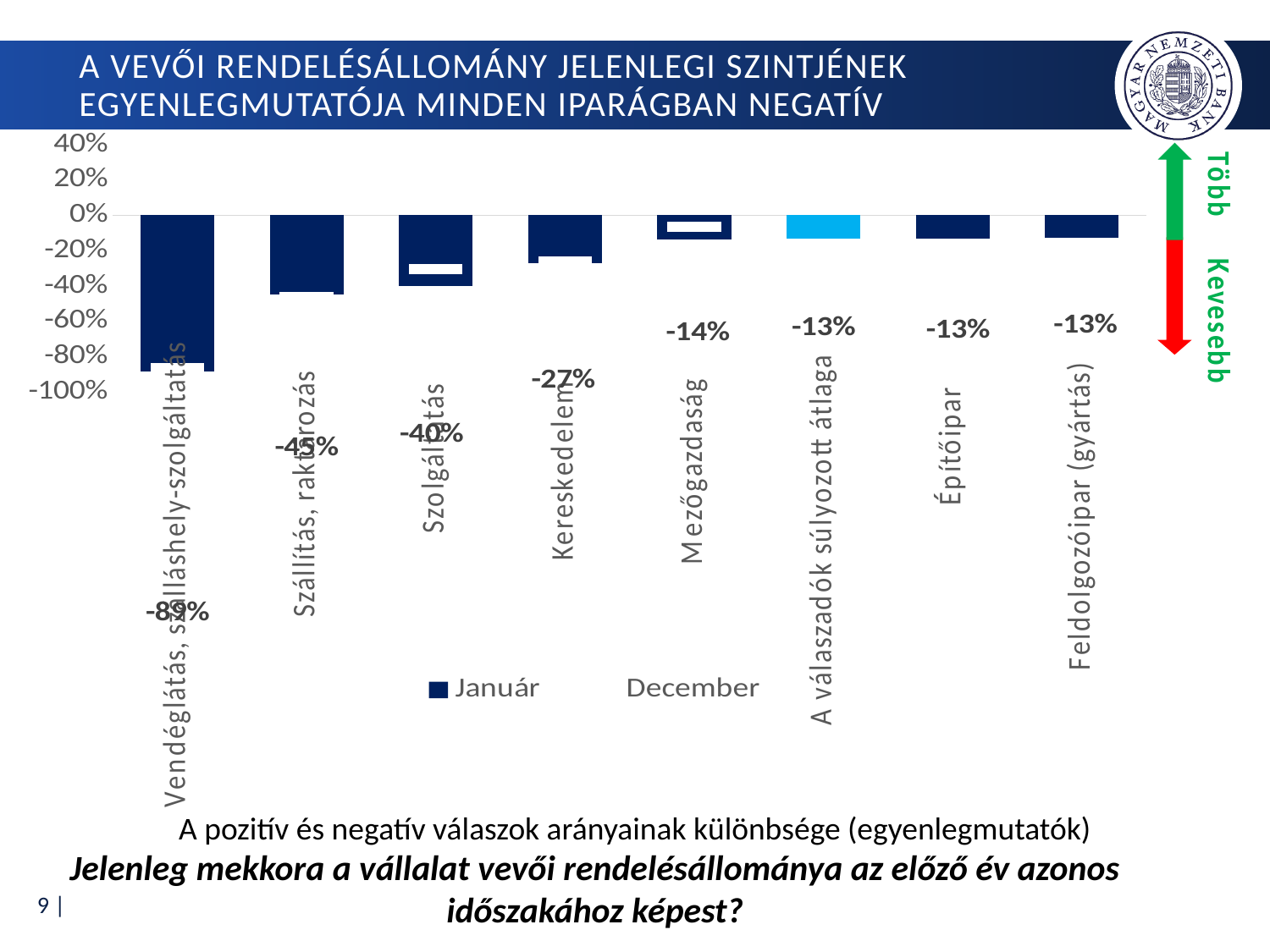
Which series is shown in dark blue according to the legend? Január What is the Január value for Vendéglátás, szálláshely-szolgáltatás? -89% How many series does the legend list? 2 What is the Január value for Szállítás, raktározás? -45% What kind of chart is shown on the slide? bar chart Is the December value for Szolgáltatás greater or less than -20%? less What is the Január value for A válaszadók súlyozott átlaga? -13% How many categories are shown on the x axis? 8 What is the difference between the Január values for Vendéglátás, szálláshely-szolgáltatás and Szállítás, raktározás? 44 percentage points Which category has the lowest Január value? Vendéglátás, szálláshely-szolgáltatás Which has the higher Január value, Kereskedelem or Mezőgazdaság? Mezőgazdaság What is the Január value for Kereskedelem? -27%